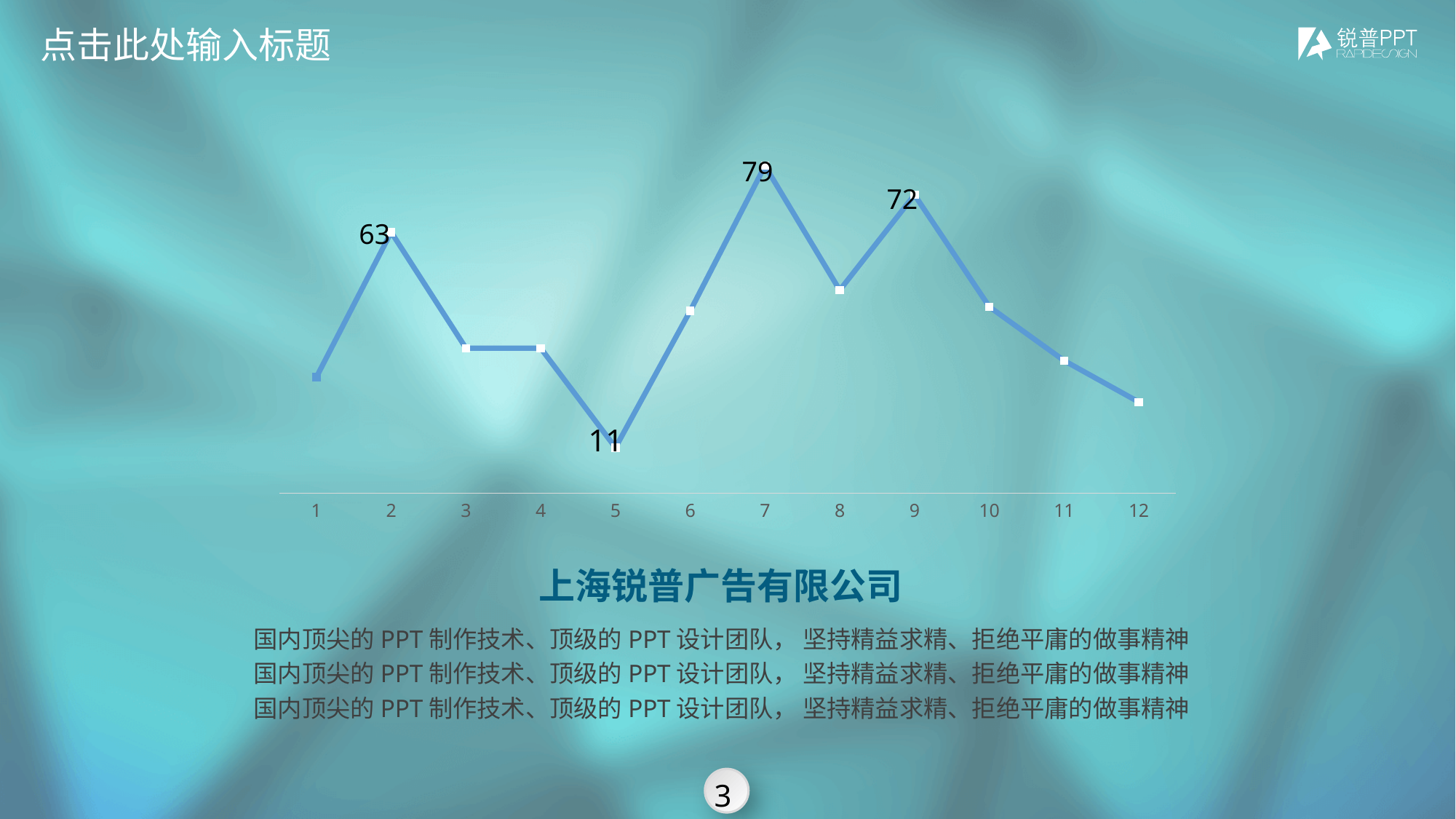
How many data points are plotted on the chart? 12 What is the difference between the values at category 2 and category 5? 52 What is the value at category 9? 72 Which category has the lowest value? 5 Which is larger, the value at category 2 or the value at category 9? category 9 Which category has the highest value? 7 What is the value at category 2? 63 Do the values rise or fall from category 9 to category 12? fall What is the difference between the values at category 7 and category 9? 7 What is the value at category 5? 11 What is the value at category 7? 79 What kind of chart is shown on the slide? line chart